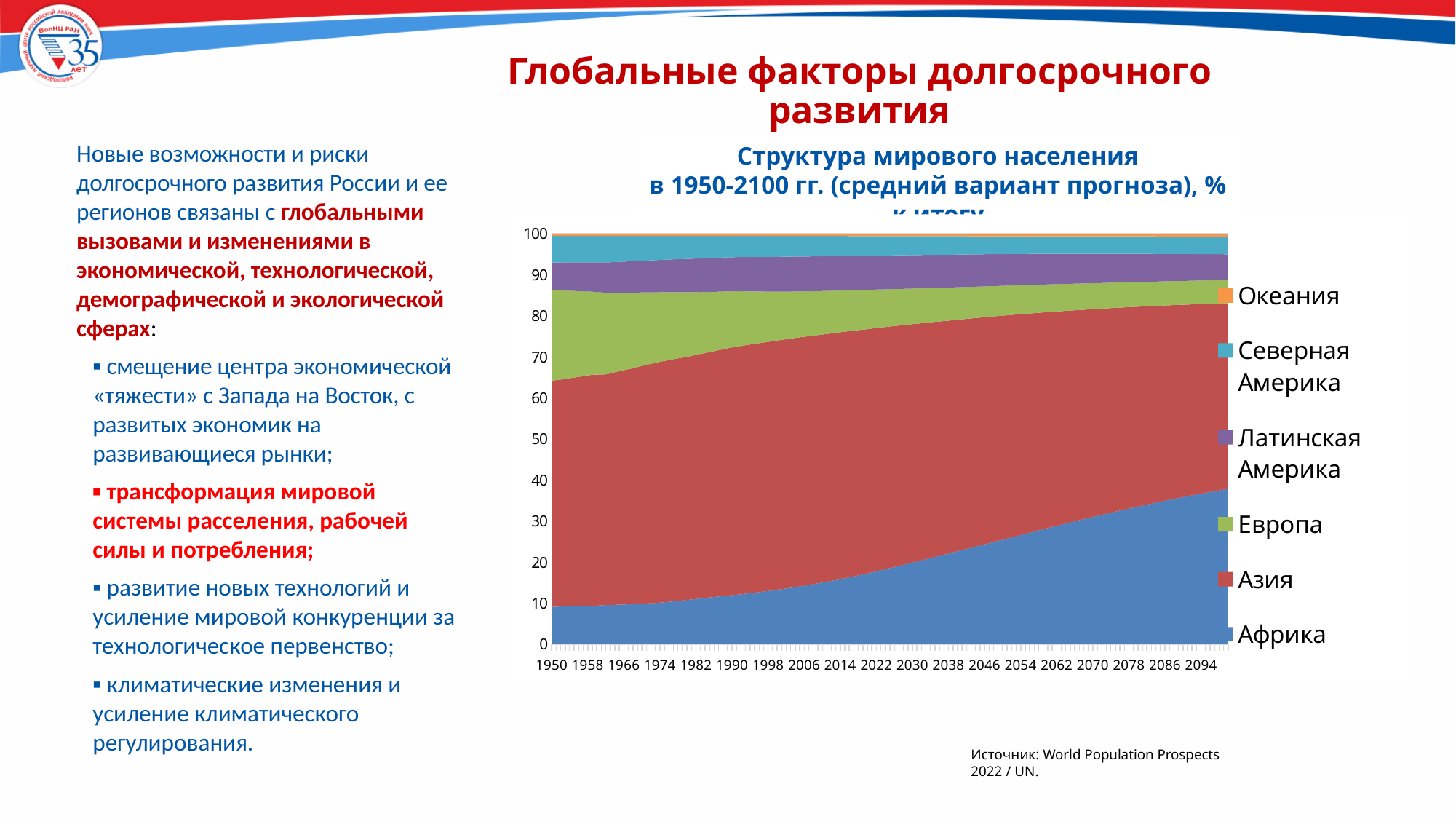
Does the share of Европа rise or fall from 1950 to 2094? Falls What kind of chart is shown on the slide? Stacked area chart How many year labels are shown on the x axis? 19 What colour represents Азия in the chart? Red Which series is listed first (at the top) in the chart legend? Океания Which region has the largest share of world population in 2094? Азия Which region has the smallest share of world population in 1950? Океания Does the share of Африка rise or fall from 1950 to 2094? Rises Is the share of Африка in 2094 greater or less than 30? greater Is the share of Азия in 1950 greater or less than 50? greater How many series does the chart legend list? 6 In 1950, which has the larger share: Европа or Северная Америка? Европа